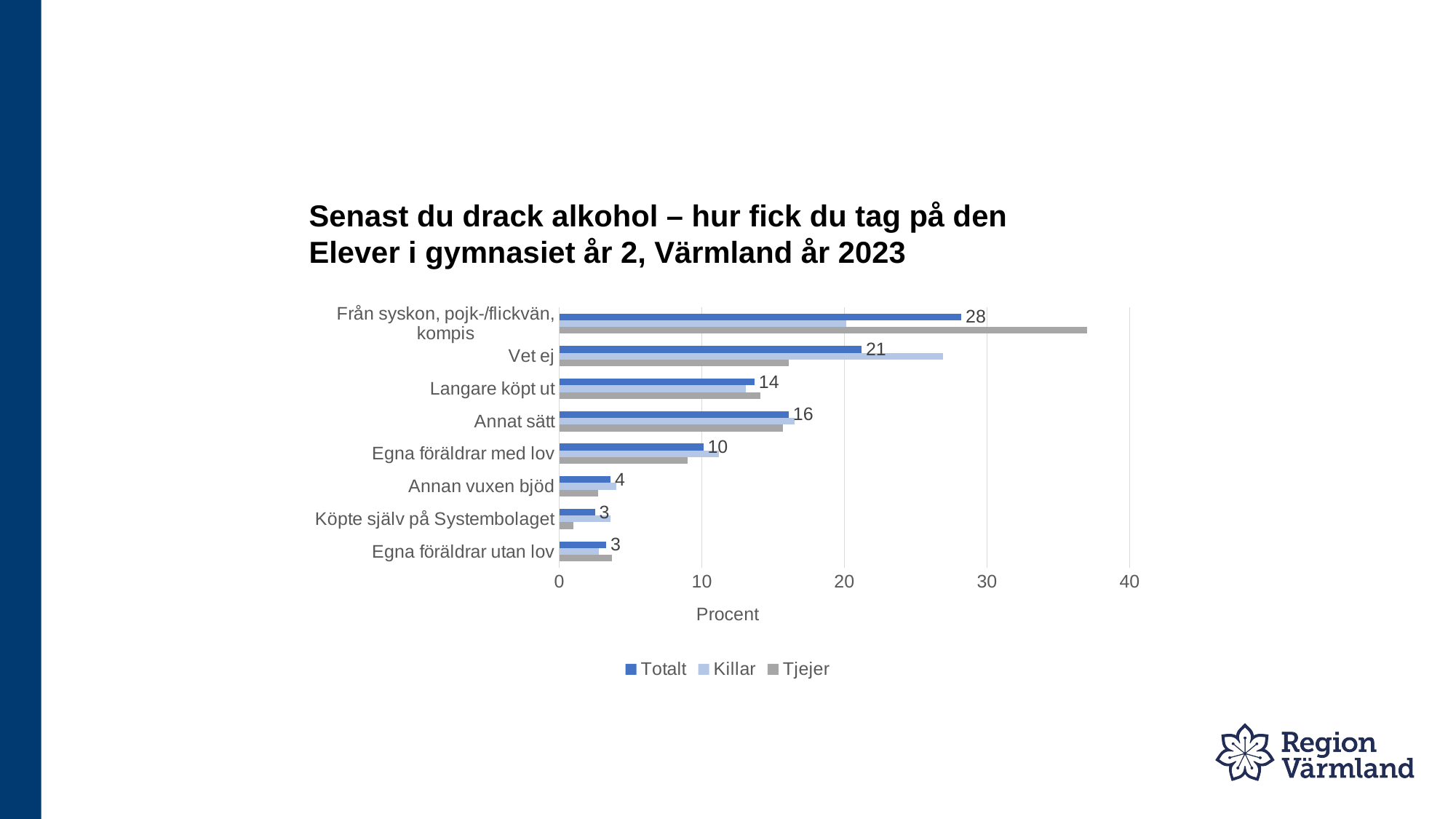
What is the difference between the Totalt values for "Från syskon, pojk-/flickvän, kompis" and "Vet ej"? 7 Which has the larger Totalt value, "Annat sätt" or "Langare köpt ut"? Annat sätt How many series does the legend list? 3 What is the Totalt value for "Vet ej"? 21 What kind of chart is shown on the slide? Bar chart How many categories are shown on the chart? 8 Is the Tjejer value for "Från syskon, pojk-/flickvän, kompis" greater or less than 30? greater Which category has the highest Totalt value? Från syskon, pojk-/flickvän, kompis What is the Totalt value for "Annat sätt"? 16 What is the Totalt value for "Från syskon, pojk-/flickvän, kompis"? 28 Is the Killar value for "Vet ej" greater or less than 20? greater What is the Totalt value for "Egna föräldrar med lov"? 10